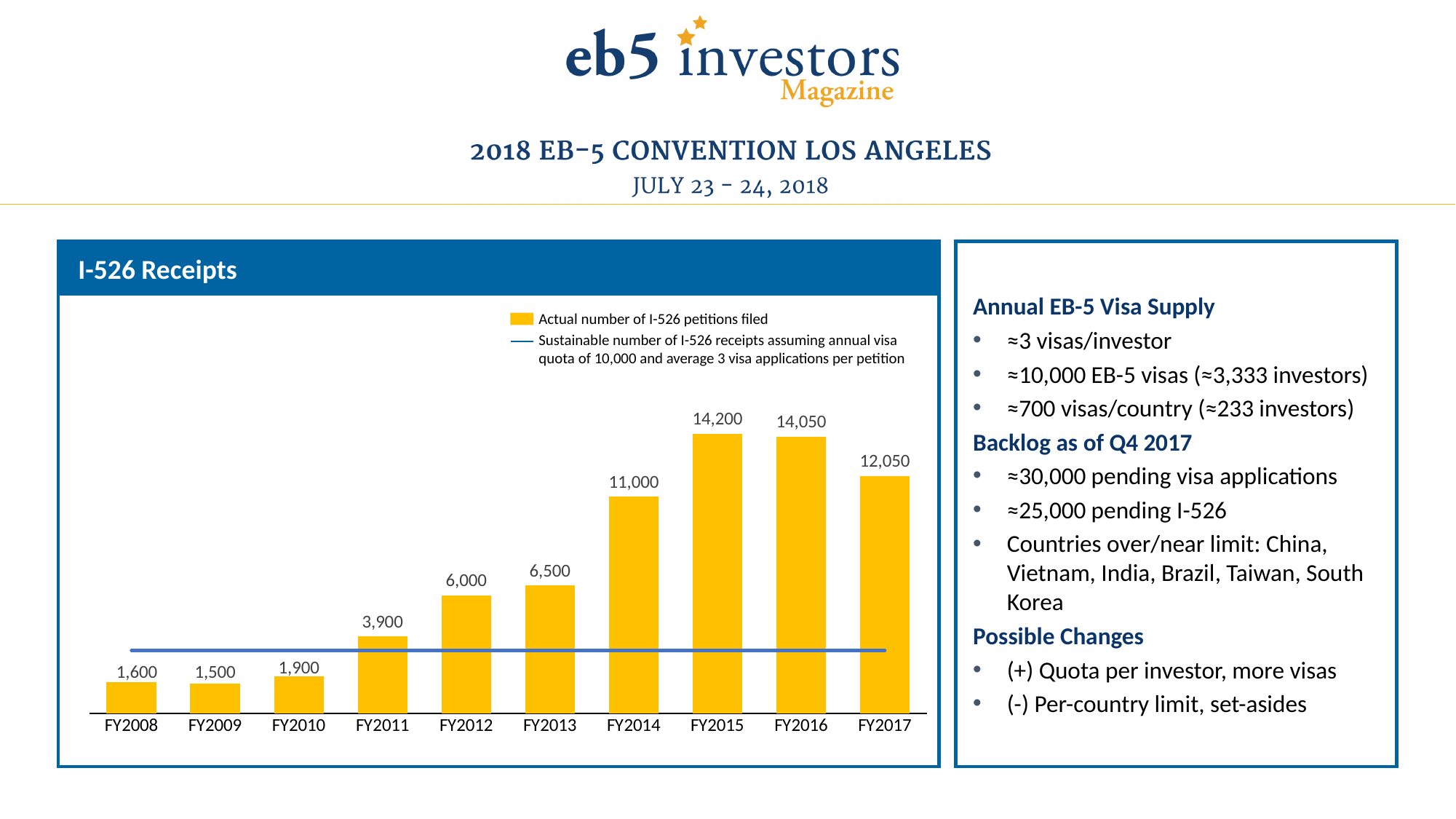
What is the actual number of I-526 petitions filed in FY2011? 3,900 How many fiscal years are shown on the x axis of the I-526 Receipts chart? 10 What is the actual number of I-526 petitions filed in FY2015? 14,200 What is the difference between the number of I-526 petitions filed in FY2014 and FY2013? 4,500 What is the actual number of I-526 petitions filed in FY2017? 12,050 What type of chart is used to show the actual number of I-526 petitions filed? Bar chart Which fiscal year has the highest number of I-526 petitions filed? FY2015 What colour are the bars for the actual number of I-526 petitions filed? Yellow What is the difference between the number of I-526 petitions filed in FY2015 and FY2016? 150 Which fiscal year has the lowest number of I-526 petitions filed? FY2009 Which year had more I-526 petitions filed, FY2012 or FY2013? FY2013 How many series does the legend of the I-526 Receipts chart list? 2